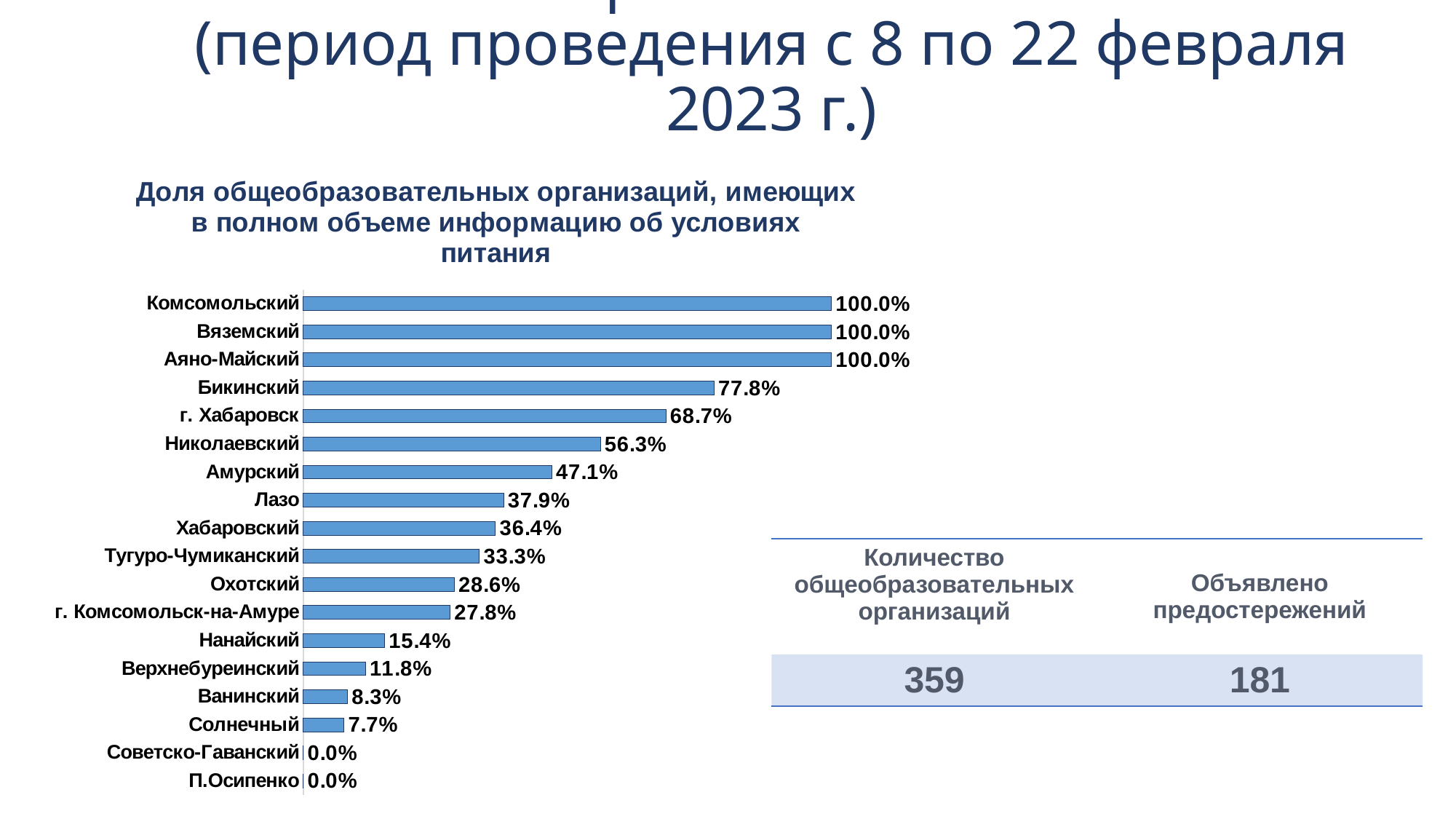
What is the value for Бикинский? 77.8% What is the value for г. Хабаровск? 68.7% Which has a larger value, Лазо or Хабаровский? Лазо What is the value for Тугуро-Чумиканский? 33.3% What is the difference between the values for Бикинский and Нанайский? 62.4% Which has a larger value, Ванинский or Верхнебуреинский? Верхнебуреинский How many categories have a value of 100.0%? 3 What kind of chart is shown on the slide? Bar chart What is the value for г. Комсомольск-на-Амуре? 27.8% What is the value for Солнечный? 7.7% How many categories are shown in the chart? 18 What is the difference between the values for Николаевский and Амурский? 9.2%